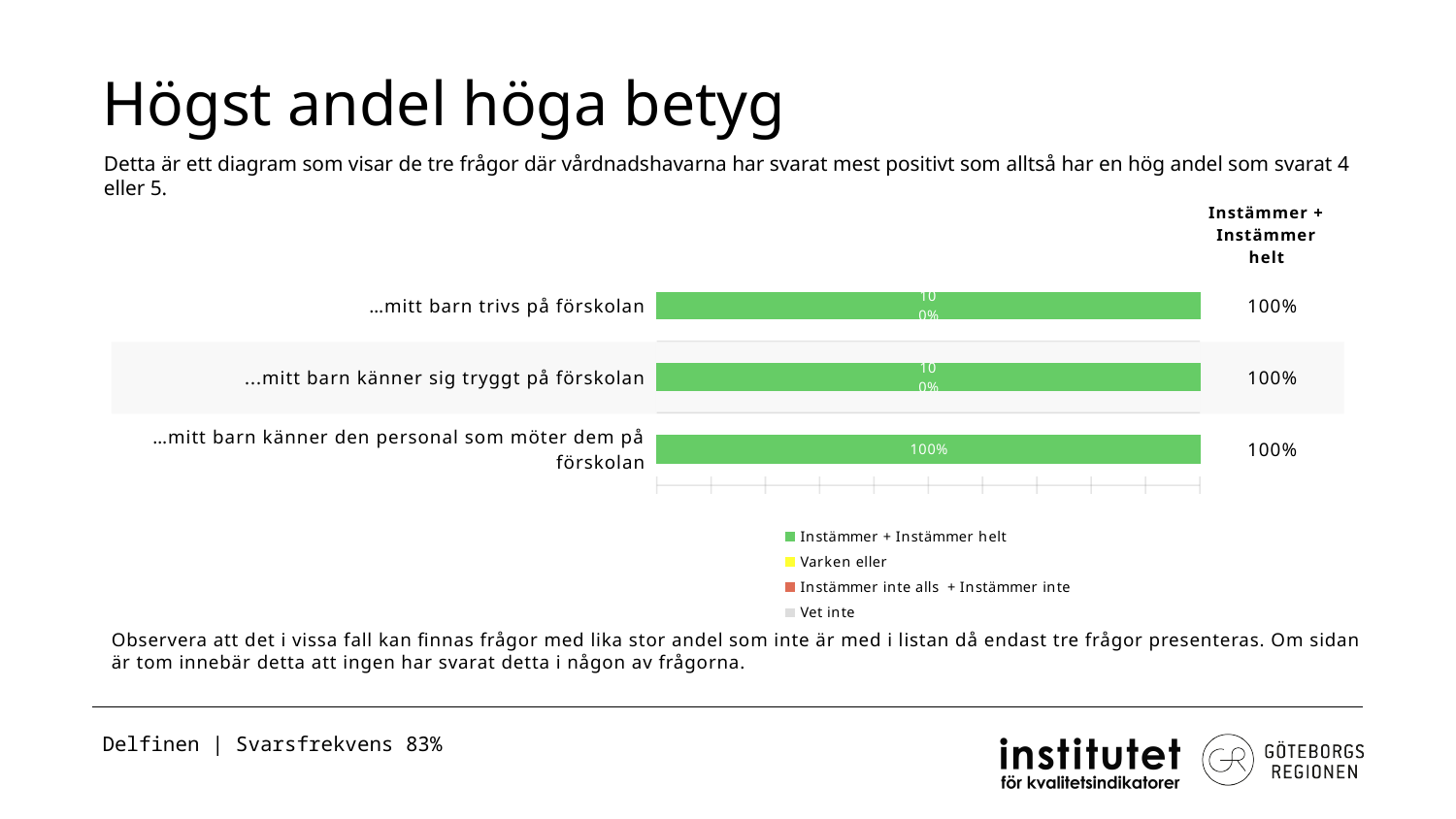
What is the 'Instämmer + Instämmer helt' value for '…mitt barn trivs på förskolan'? 100% What is the heading of the column of values to the right of the bars? Instämmer + Instämmer helt What is the 'Instämmer + Instämmer helt' value for '…mitt barn känner den personal som möter dem på förskolan'? 100% How many series does the chart legend list? 4 What kind of chart is shown on the slide? bar chart What is the title of the slide containing the chart? Högst andel höga betyg Is the value for '…mitt barn trivs på förskolan' greater or less than 50%? greater What is the difference between the 'Instämmer + Instämmer helt' values for '…mitt barn trivs på förskolan' and '…mitt barn känner den personal som möter dem på förskolan'? 0% What is the 'Instämmer + Instämmer helt' value for '...mitt barn känner sig tryggt på förskolan'? 100% Which legend entry is shown in green? Instämmer + Instämmer helt How many categories (questions) are plotted in the chart? 3